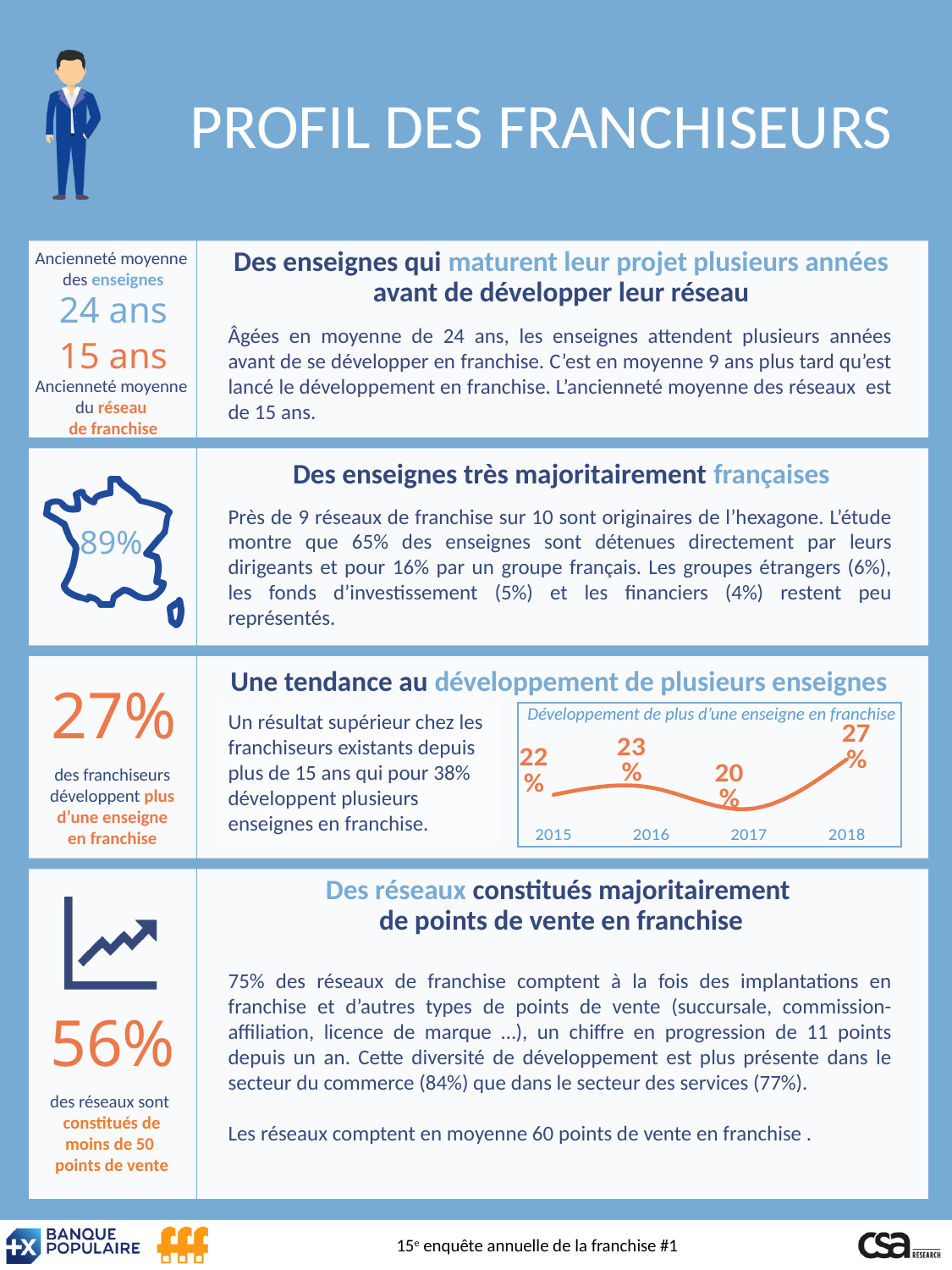
Which year has the lowest value in the chart 'Développement de plus d'une enseigne en franchise'? 2017 In the chart 'Développement de plus d'une enseigne en franchise', which is larger, the value for 2016 or the value for 2017? 2016 What is the value for 2018 in the chart 'Développement de plus d'une enseigne en franchise'? 27% Which year has the highest value in the chart 'Développement de plus d'une enseigne en franchise'? 2018 What kind of chart is 'Développement de plus d'une enseigne en franchise'? Line chart What is the difference between the 2018 and 2017 values in the chart 'Développement de plus d'une enseigne en franchise'? 7 points What is the value for 2017 in the chart 'Développement de plus d'une enseigne en franchise'? 20% In the chart 'Développement de plus d'une enseigne en franchise', does the value rise or fall from 2017 to 2018? Rise What is the difference between the 2016 and 2015 values in the chart 'Développement de plus d'une enseigne en franchise'? 1 point What is the title of the chart on the slide? Développement de plus d'une enseigne en franchise What is the value for 2015 in the chart 'Développement de plus d'une enseigne en franchise'? 22% How many years are plotted in the chart 'Développement de plus d'une enseigne en franchise'? 4